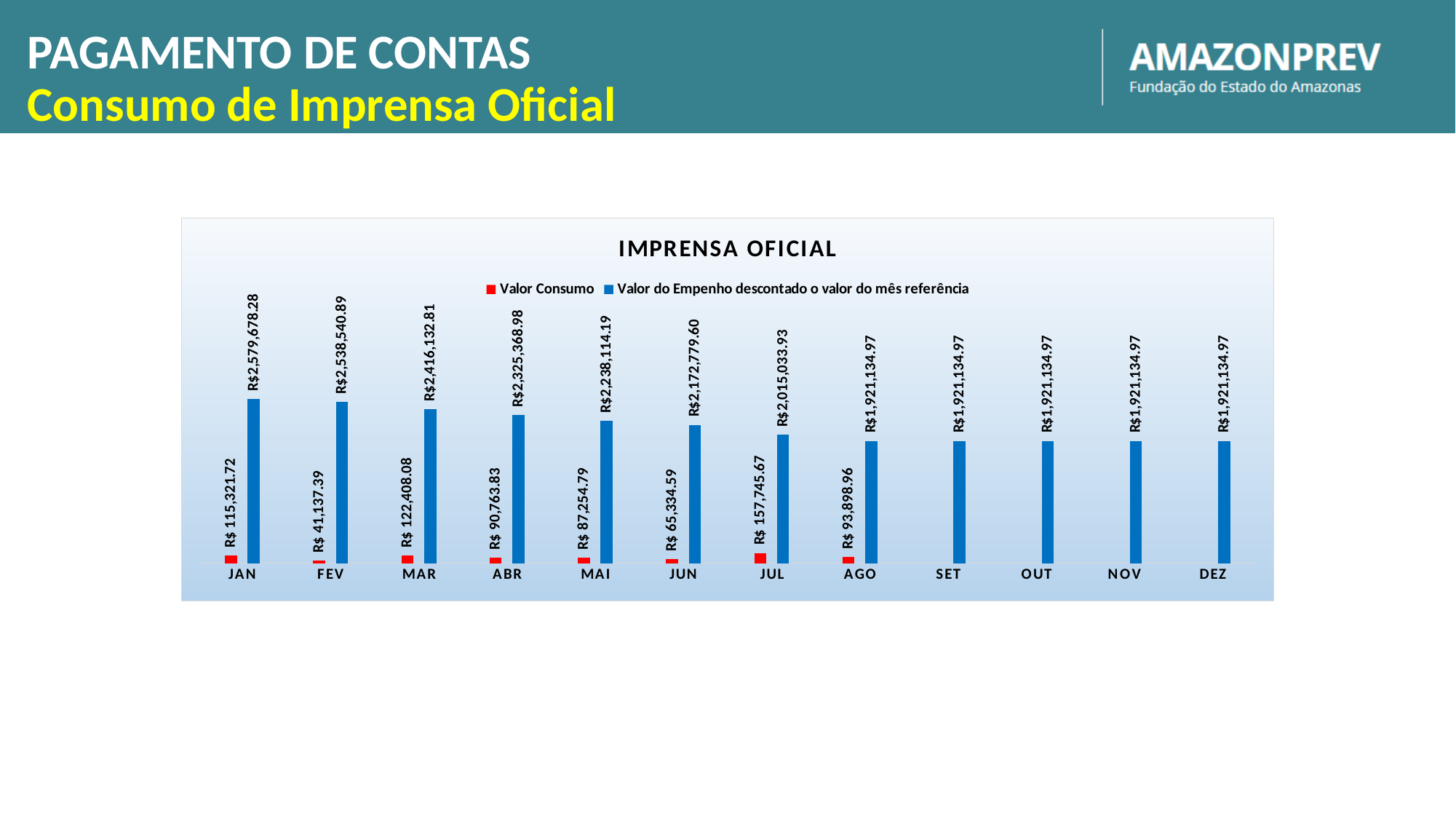
What is the title of the chart? IMPRENSA OFICIAL What is the Valor do Empenho descontado o valor do mês referência for DEZ? R$1,921,134.97 Which month has the highest Valor do Empenho descontado o valor do mês referência? JAN What type of chart is shown on the slide? Bar chart What is the difference between the Valor Consumo for JAN and FEV? R$ 74,184.33 What is the Valor do Empenho descontado o valor do mês referência for MAR? R$2,416,132.81 Which month has the highest Valor Consumo? JUL Does the Valor do Empenho descontado o valor do mês referência rise or fall from JAN to AGO? Fall How many months are shown on the x axis? 12 What is the Valor Consumo for JUL? R$ 157,745.67 How many series does the legend list? 2 Which month has the lowest Valor Consumo? FEV